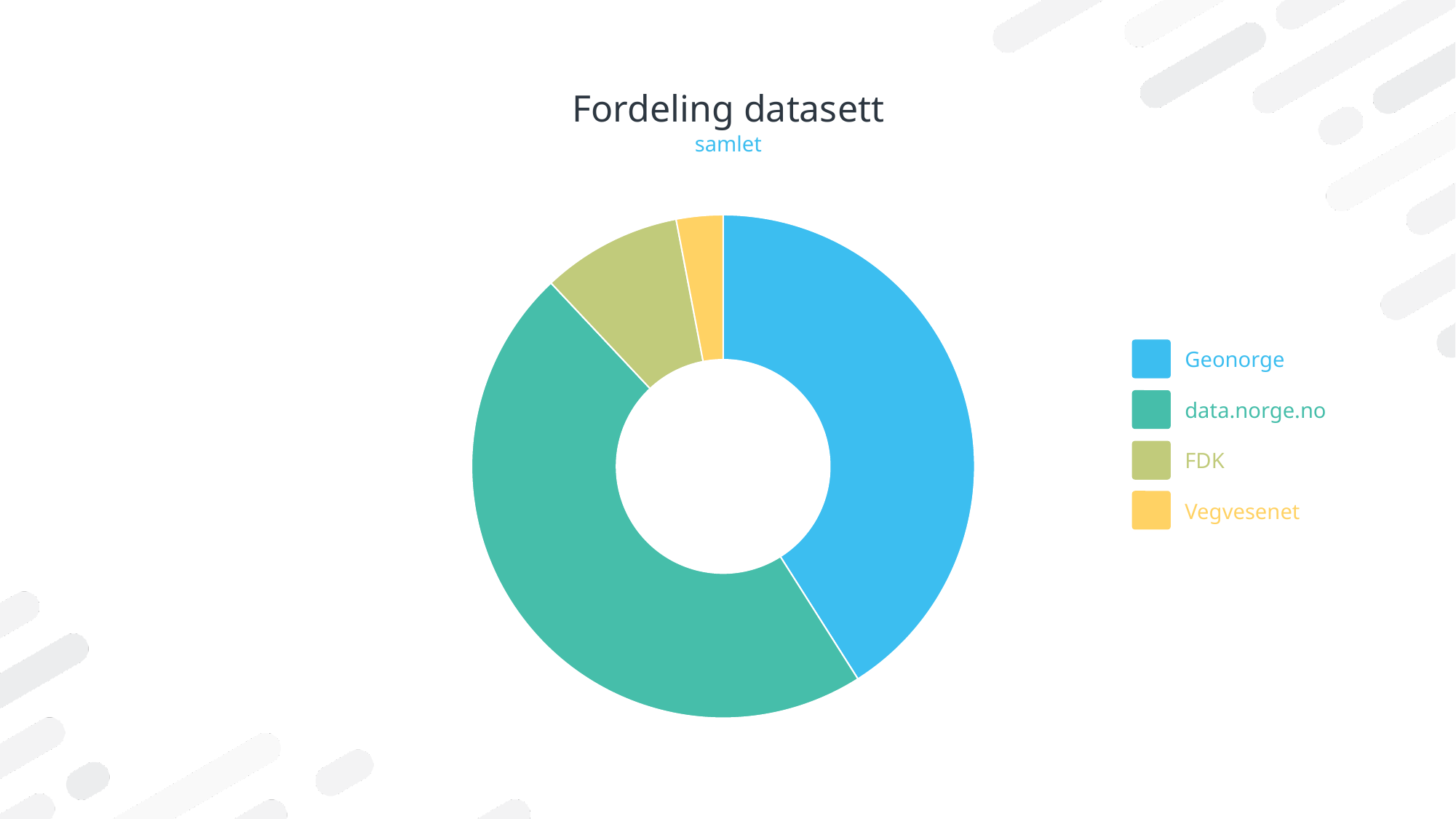
Which slice is larger, data.norge.no or Vegvesenet? data.norge.no Which slice is larger, FDK or Vegvesenet? FDK Which slice is larger, Geonorge or FDK? Geonorge Which category has the smallest slice? Vegvesenet How many entries does the legend list? 4 Which category has the largest slice? data.norge.no What kind of chart is shown on the slide? pie chart How many categories does the chart show? 4 What is the title of the chart? Fordeling datasett Which category is shown in yellow? Vegvesenet